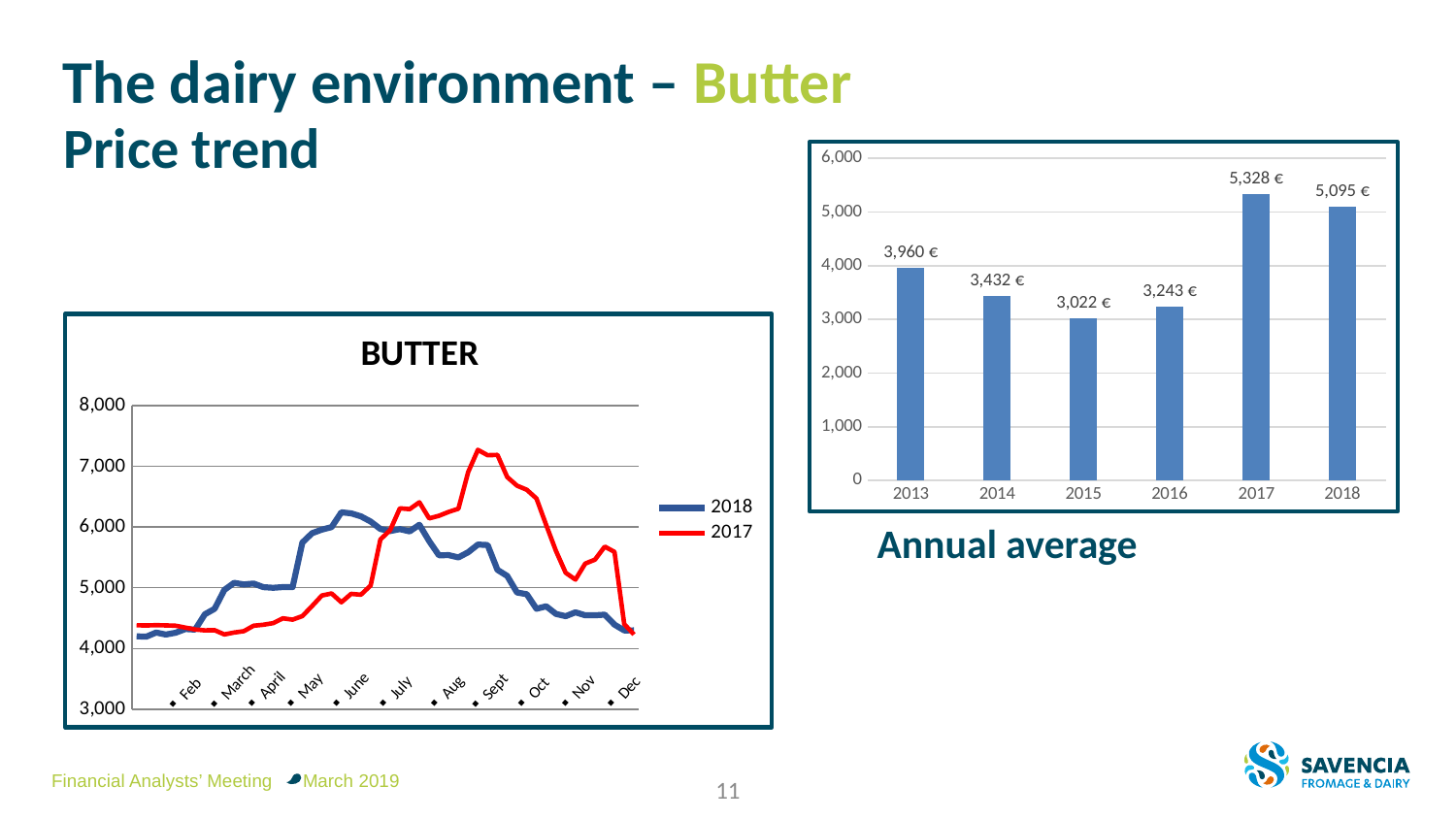
In the Annual average bar chart, what is the value for 2017? 5,328 € In the BUTTER line chart, which series is drawn in red? 2017 In the Annual average bar chart, what is the value for 2015? 3,022 € In the Annual average bar chart, which is larger, the value for 2013 or the value for 2014? 2013 What kind of chart is the Annual average chart on the right? Bar chart In the Annual average bar chart, which year has the highest value? 2017 In the Annual average bar chart, which year has the lowest value? 2015 How many series does the legend of the BUTTER line chart list? 2 In the Annual average bar chart, what is the difference between the 2017 and 2018 values? 233 € In the BUTTER line chart, does the 2018 series rise or fall from Aug to Dec? fall In the BUTTER line chart, is the 2017 value for Sept greater or less than 6,000? greater How many years are shown in the Annual average bar chart? 6